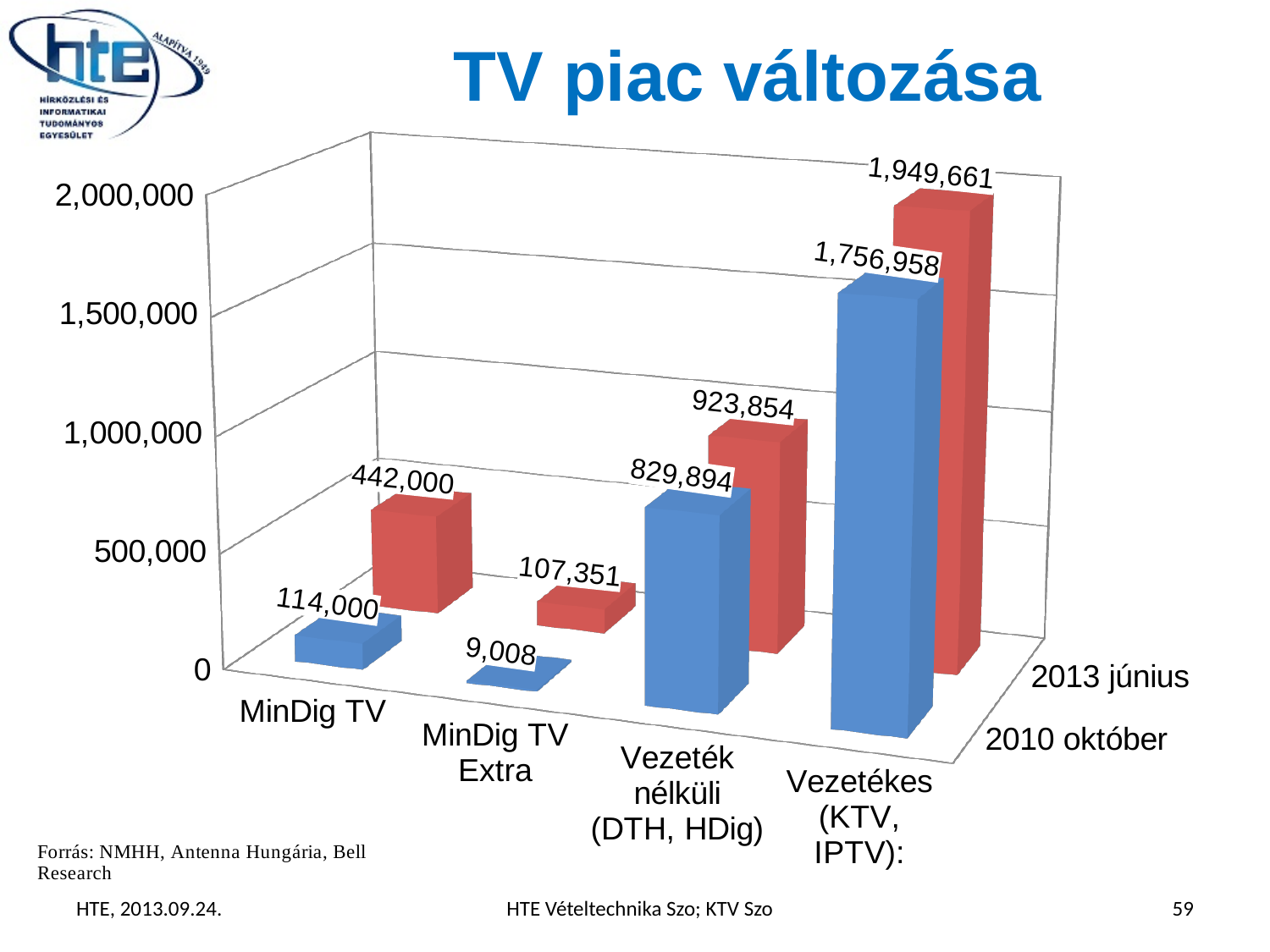
What is the difference between the 2013 június and 2010 október values for Vezetékes (KTV, IPTV)? 192,703 What is the value for MinDig TV Extra in 2010 október? 9,008 Which is larger: the 2013 június value for MinDig TV or the 2013 június value for MinDig TV Extra? MinDig TV Which category has the highest value in 2013 június? Vezetékes (KTV, IPTV) How many data series does the chart show? 2 Which category has the lowest value in 2010 október? MinDig TV Extra What is the value for Vezeték nélküli (DTH, HDig) in 2013 június? 923,854 What is the value for MinDig TV in 2010 október? 114,000 What type of chart is shown on the slide? Bar chart What is the difference between the 2013 június and 2010 október values for MinDig TV? 328,000 How many categories are shown on the x axis? 4 What is the value for Vezetékes (KTV, IPTV) in 2013 június? 1,949,661